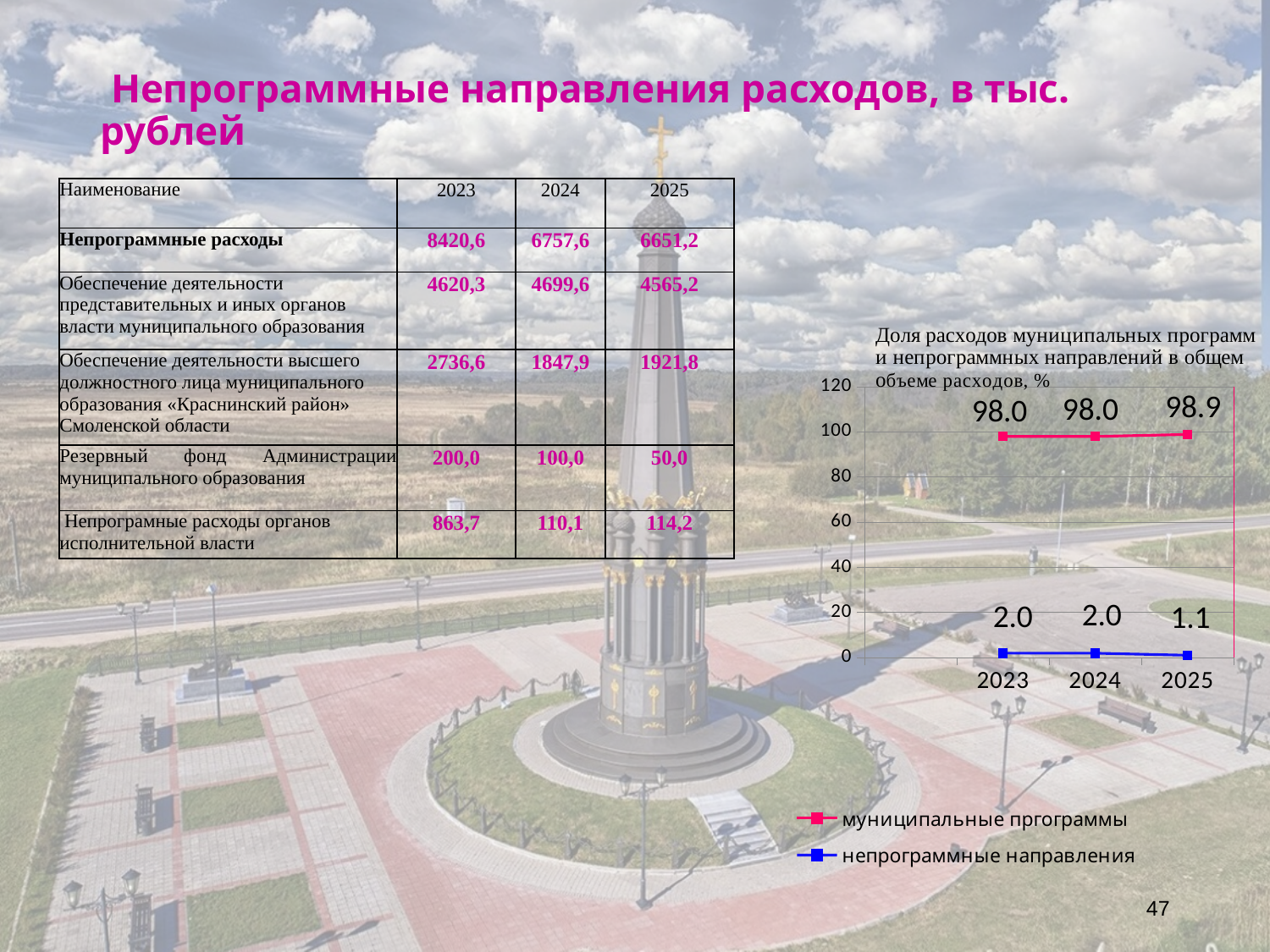
How many series does the chart legend list? 2 In which year is the value for муниципальные программы highest? 2025 What is the value for муниципальные программы in 2025? 98.9 In which year is the value for непрограммные направления lowest? 2025 What is the value for непрограммные направления in 2023? 2.0 What is the value for муниципальные программы in 2024? 98.0 What is the value for непрограммные направления in 2025? 1.1 How many years are plotted on the x axis of the chart? 3 Which series has the larger value in 2024, муниципальные программы or непрограммные направления? муниципальные программы What kind of chart is shown on the slide? line chart What is the difference between the муниципальные программы value and the непрограммные направления value in 2025? 97.8 Which colour is used for the непрограммные направления series in the chart? blue